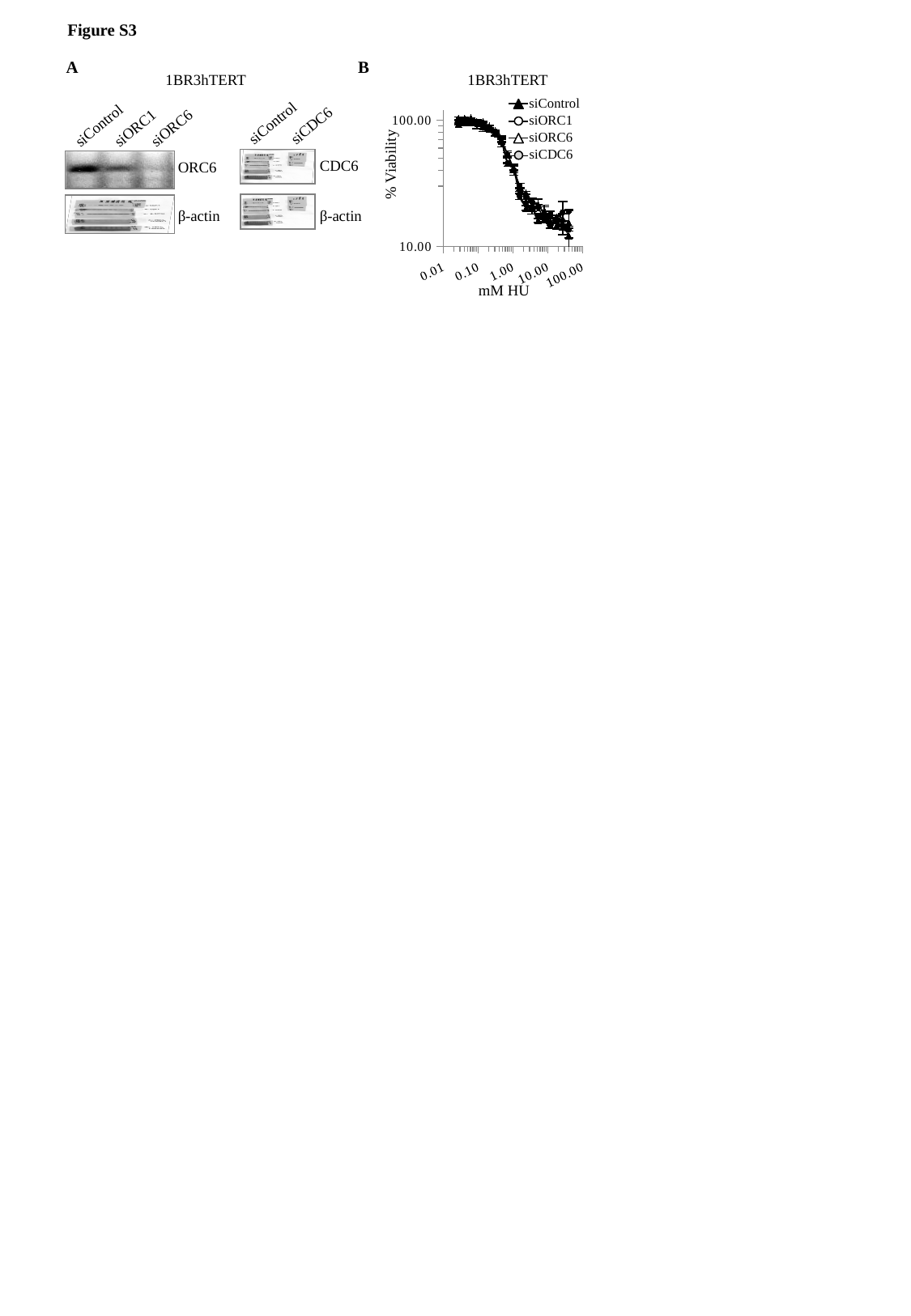
In the chart in panel B, is the % Viability for siControl at the highest HU concentrations greater or less than 100.00? less In the chart in panel B, is the % Viability for siControl at the lowest HU concentrations greater or less than 10.00? greater In the chart in panel B, do the % Viability values rise or fall as mM HU increases along the x axis? fall In the chart in panel B, which series is represented by filled triangles in the legend? siControl What is the title of the chart in panel B? 1BR3hTERT What kind of chart is shown in panel B of the slide? line chart How many series does the legend of the chart in panel B list? 4 What is the y-axis label of the chart in panel B? % Viability